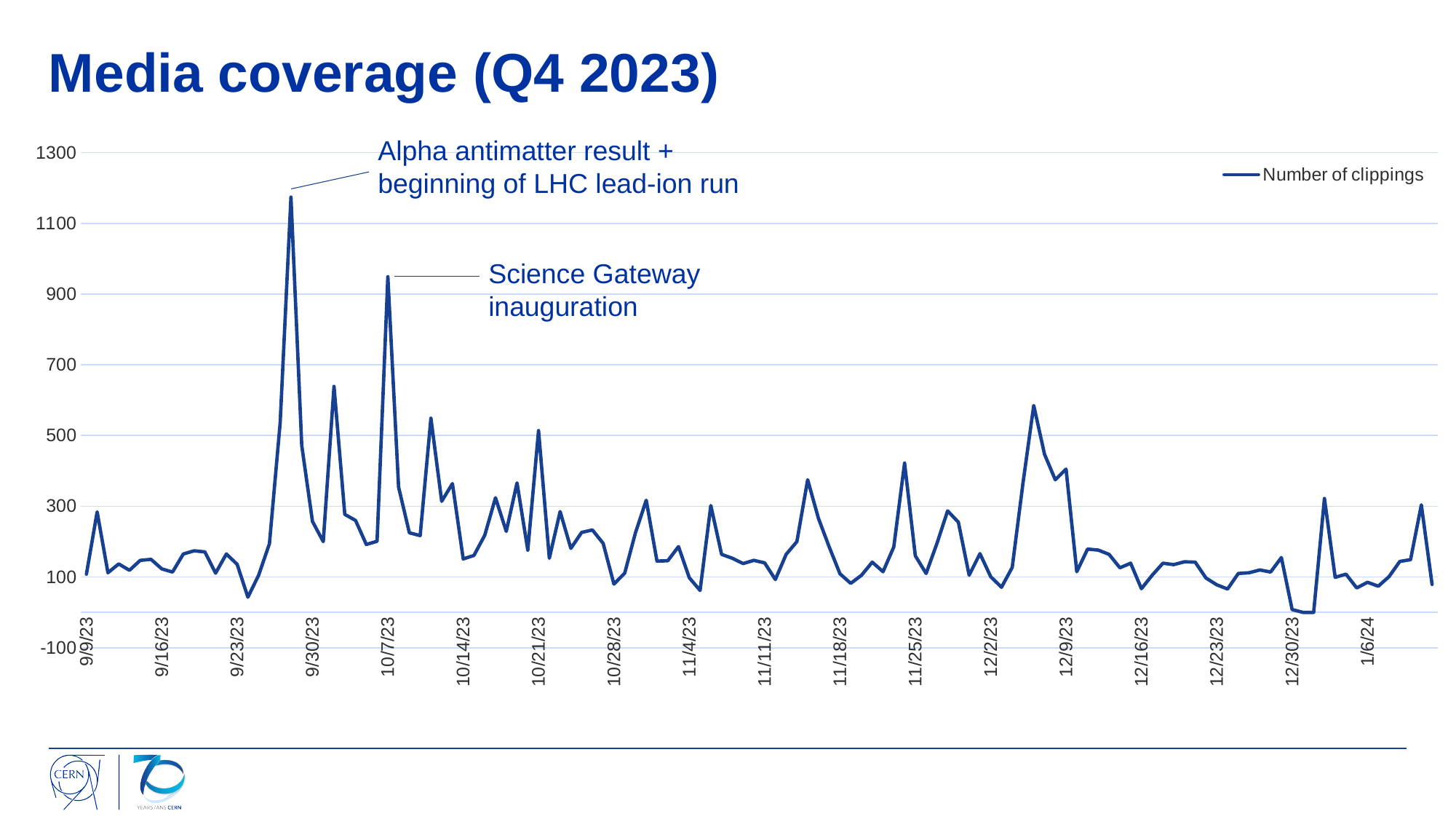
How many series does the legend list? 1 What is the name of the series shown in the legend? Number of clippings Which is higher: the peak at the Alpha antimatter result or the peak at the Science Gateway inauguration? Alpha antimatter result What is the title of the chart on the slide? Media coverage (Q4 2023) Is the number of clippings on 12/30/23 greater or less than 100? less Does the number of clippings rise or fall between 9/23/23 and the Alpha antimatter result peak? rise Is the number of clippings on 9/9/23 greater or less than 300? less Is the number of clippings at the Science Gateway inauguration peak greater or less than 900? greater What kind of chart is shown on the slide? line chart Which annotated event corresponds to the highest peak in the number of clippings? Alpha antimatter result + beginning of LHC lead-ion run